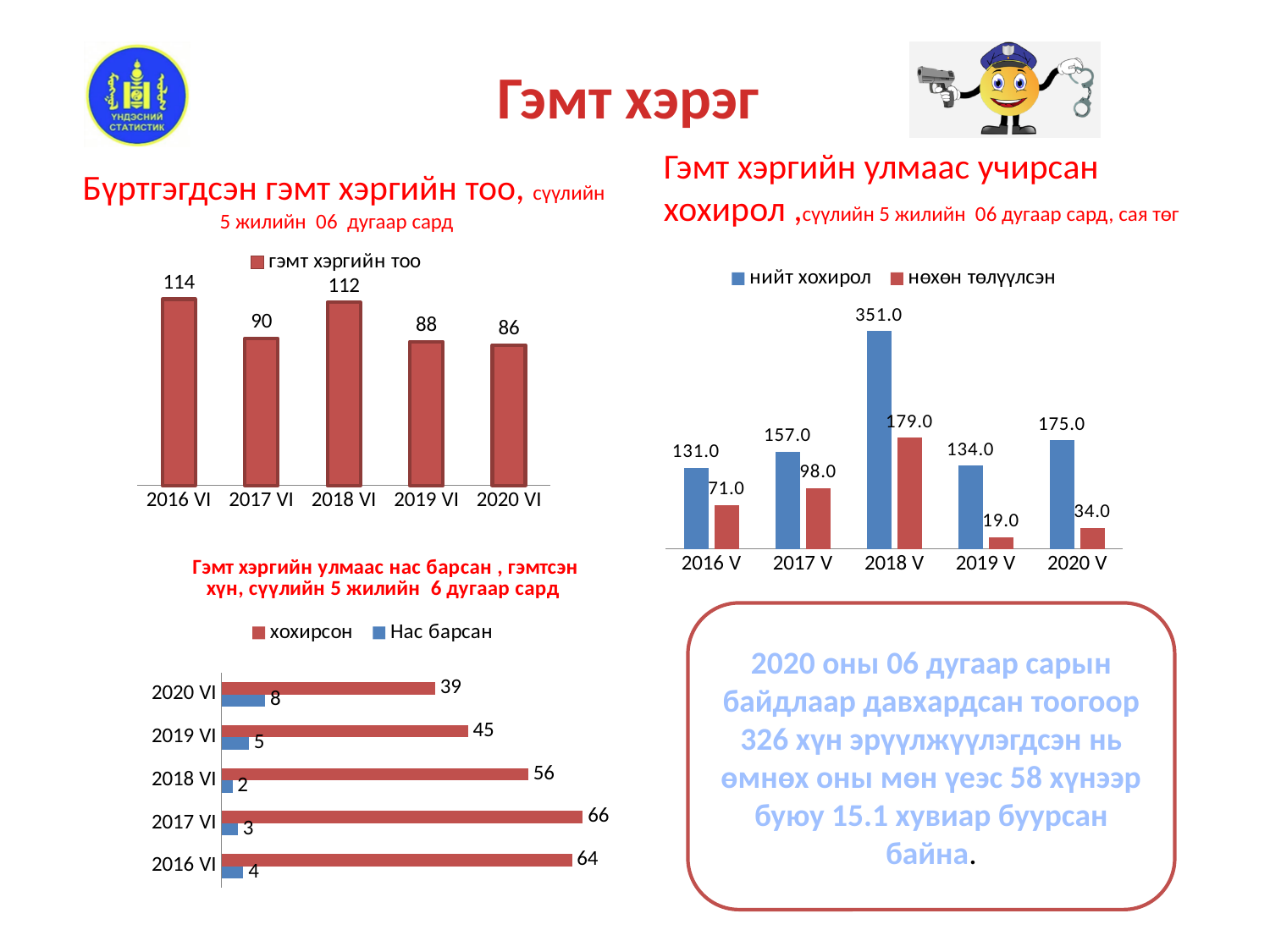
In the bottom-left chart 'Гэмт хэргийн улмаас нас барсан, гэмтсэн хүн', what is the value of 'хохирсон' for 2017 VI? 66 What kind of chart is the bottom-left chart 'Гэмт хэргийн улмаас нас барсан, гэмтсэн хүн'? Bar chart In the top-left chart 'Бүртгэгдсэн гэмт хэргийн тоо', which category has the lowest value? 2020 VI In the bottom-left chart 'Гэмт хэргийн улмаас нас барсан, гэмтсэн хүн', how many categories are shown? 5 In the top-right chart 'Гэмт хэргийн улмаас учирсан хохирол', how many series does the legend list? 2 In the top-left chart 'Бүртгэгдсэн гэмт хэргийн тоо', what is the value for 2018 VI? 112 In the top-left chart 'Бүртгэгдсэн гэмт хэргийн тоо', which category has the highest value? 2016 VI In the top-right chart 'Гэмт хэргийн улмаас учирсан хохирол', what is the difference between 'нийт хохирол' and 'нөхөн төлүүлсэн' for 2020 V? 141.0 In the top-right chart 'Гэмт хэргийн улмаас учирсан хохирол', what is the value of 'нийт хохирол' for 2018 V? 351.0 In the top-left chart 'Бүртгэгдсэн гэмт хэргийн тоо', what is the difference between the values for 2016 VI and 2017 VI? 24 In the top-right chart 'Гэмт хэргийн улмаас учирсан хохирол', what is the value of 'нөхөн төлүүлсэн' for 2019 V? 19.0 In the bottom-left chart 'Гэмт хэргийн улмаас нас барсан, гэмтсэн хүн', which category has the highest value of 'Нас барсан'? 2020 VI